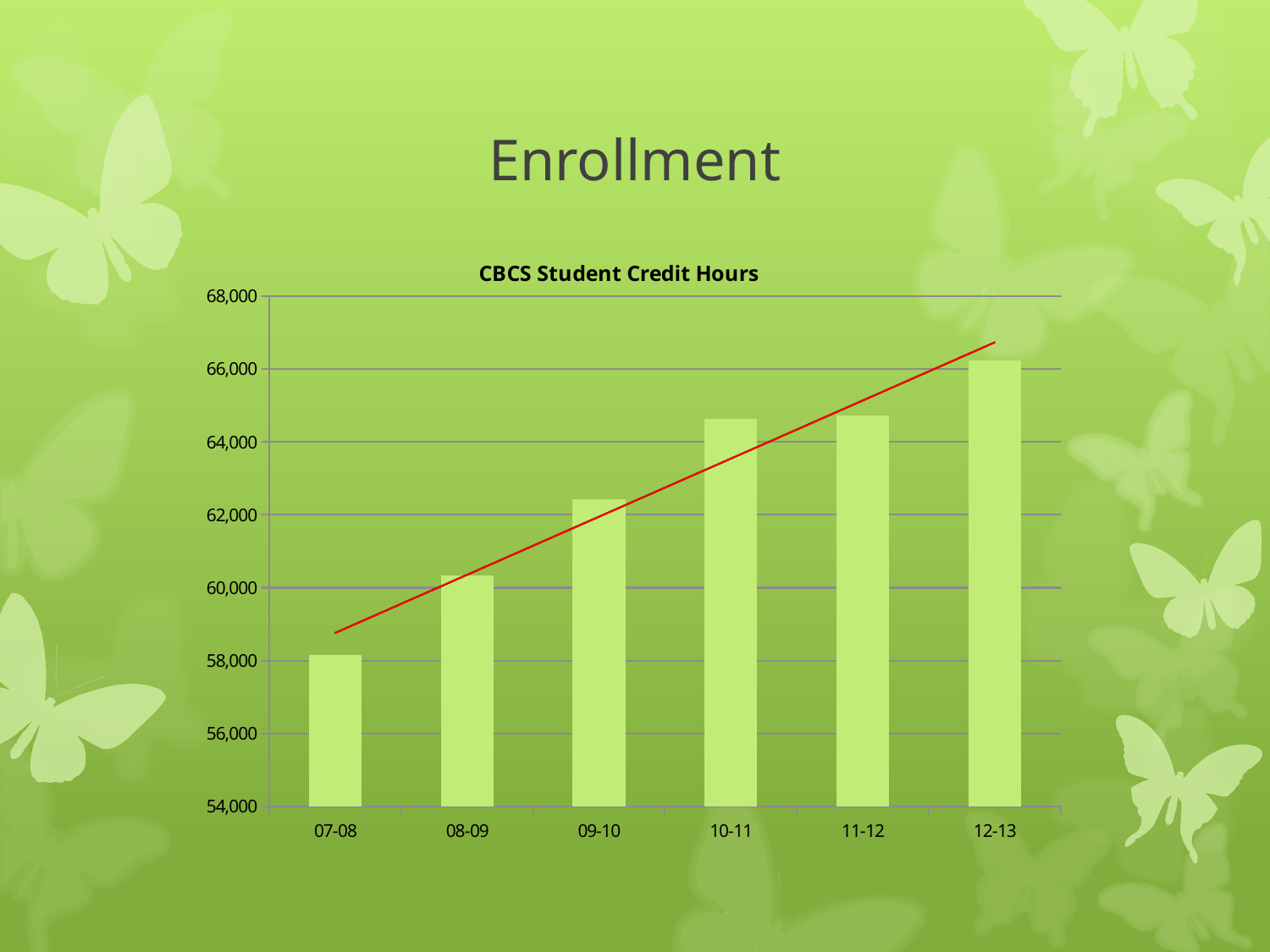
Is the value for 10-11 greater or less than 64,000? greater Is the value for 07-08 greater or less than 60,000? less Which academic year has the lowest CBCS student credit hours? 07-08 Which is larger, the value for 09-10 or the value for 12-13? 12-13 How many academic years are shown on the x axis of the chart? 6 Do the CBCS student credit hours generally rise or fall from 07-08 to 12-13? rise Which academic year has the highest CBCS student credit hours? 12-13 Is the value for 08-09 greater or less than 62,000? less What is the title of the chart? CBCS Student Credit Hours What type of chart is shown on the slide? bar chart